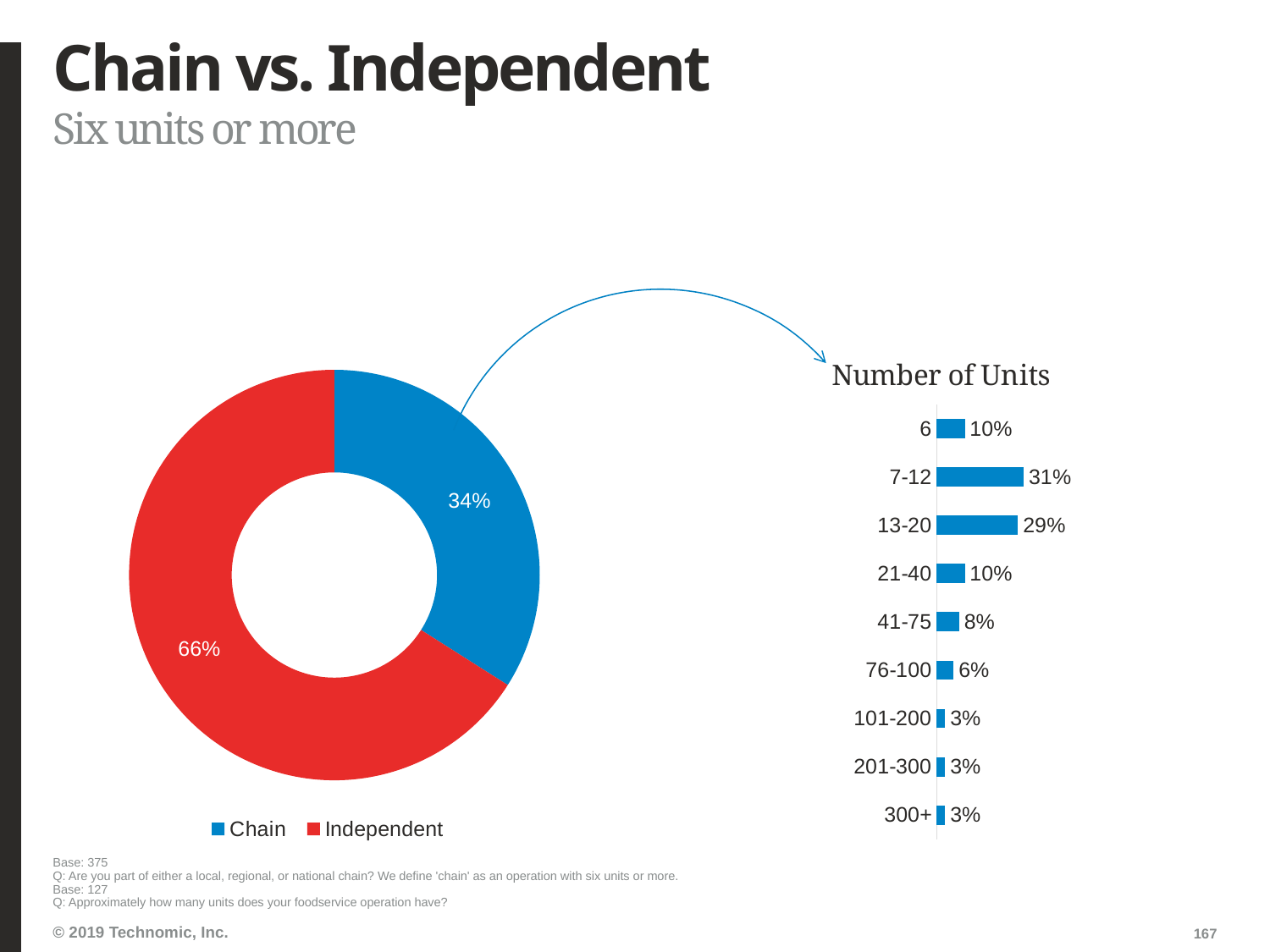
In the donut chart on the left, what percentage is shown for Chain? 34% In the Number of Units chart, what is the value for 13-20? 29% In the Number of Units chart, what is the value for 7-12? 31% In the donut chart on the left, what percentage is shown for Independent? 66% In the donut chart on the left, what colour represents Chain? Blue In the Number of Units chart, what is the value for 76-100? 6% In the Number of Units chart, which category has the highest value? 7-12 In the Number of Units chart, what is the difference between the values for 7-12 and 41-75? 23% What kind of chart is the Number of Units chart? Bar chart In the donut chart on the left, how many entries does the legend list? 2 In the donut chart on the left, which segment is larger, Chain or Independent? Independent In the Number of Units chart, how many categories are shown? 9